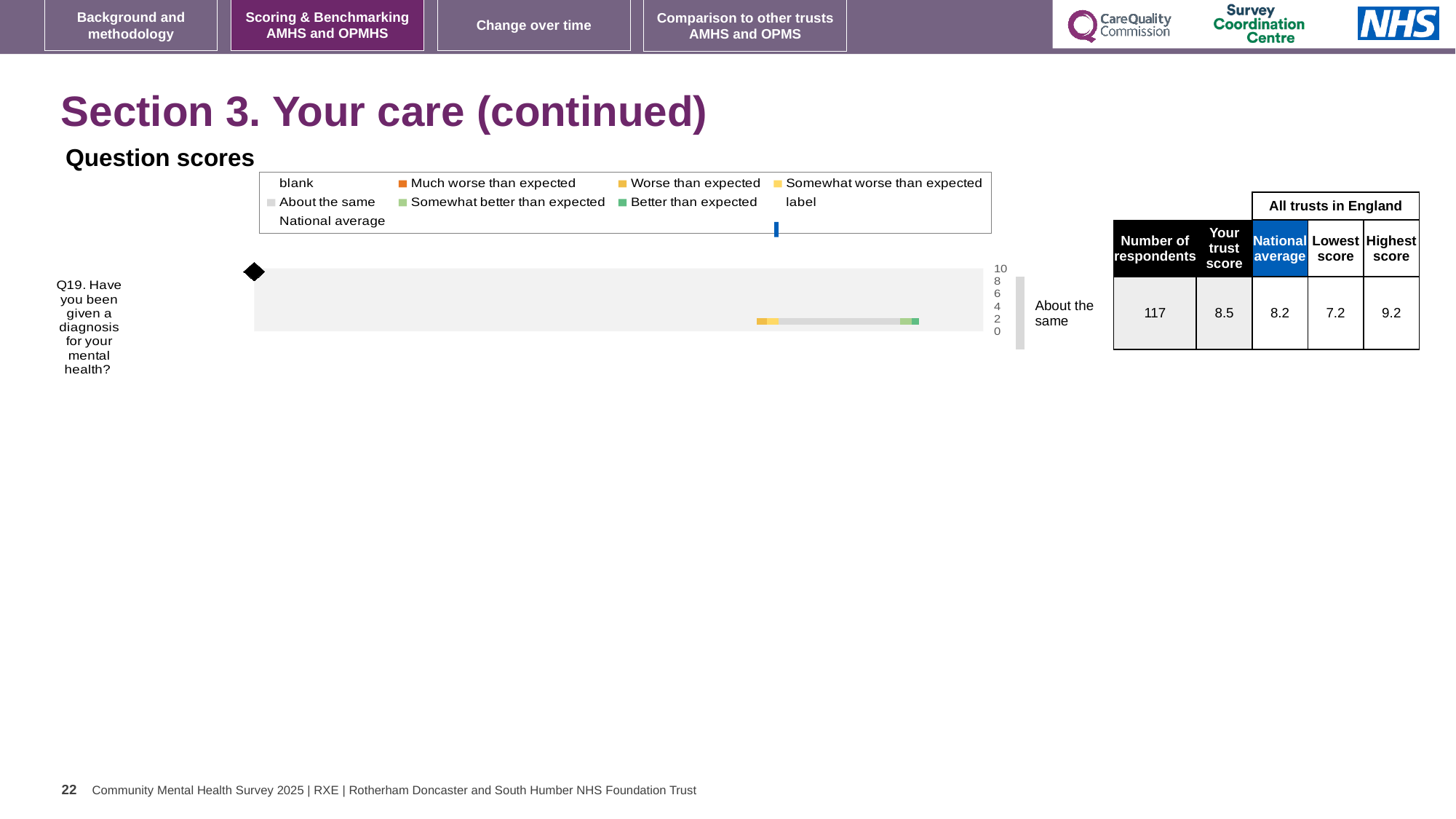
In the table beside the chart, what is the number of respondents for Q19? 117 What benchmark category label is shown next to the bar for Q19? About the same For Q19, what is the difference between the highest score and the lowest score among all trusts in England? 2.0 In the table beside the chart, what is the highest score among all trusts in England for Q19? 9.2 In the table beside the chart, what is the national average for Q19? 8.2 How many questions (categories) are plotted in the Question scores chart? 1 In the table beside the chart, what is the lowest score among all trusts in England for Q19? 7.2 In the table beside the chart, what is 'Your trust score' for Q19? 8.5 What kind of chart is shown under 'Question scores'? bar chart For Q19, which is larger: your trust score or the national average? Your trust score Which question is plotted in the Question scores chart? Q19. Have you been given a diagnosis for your mental health? For Q19, what is the difference between your trust score and the national average? 0.3